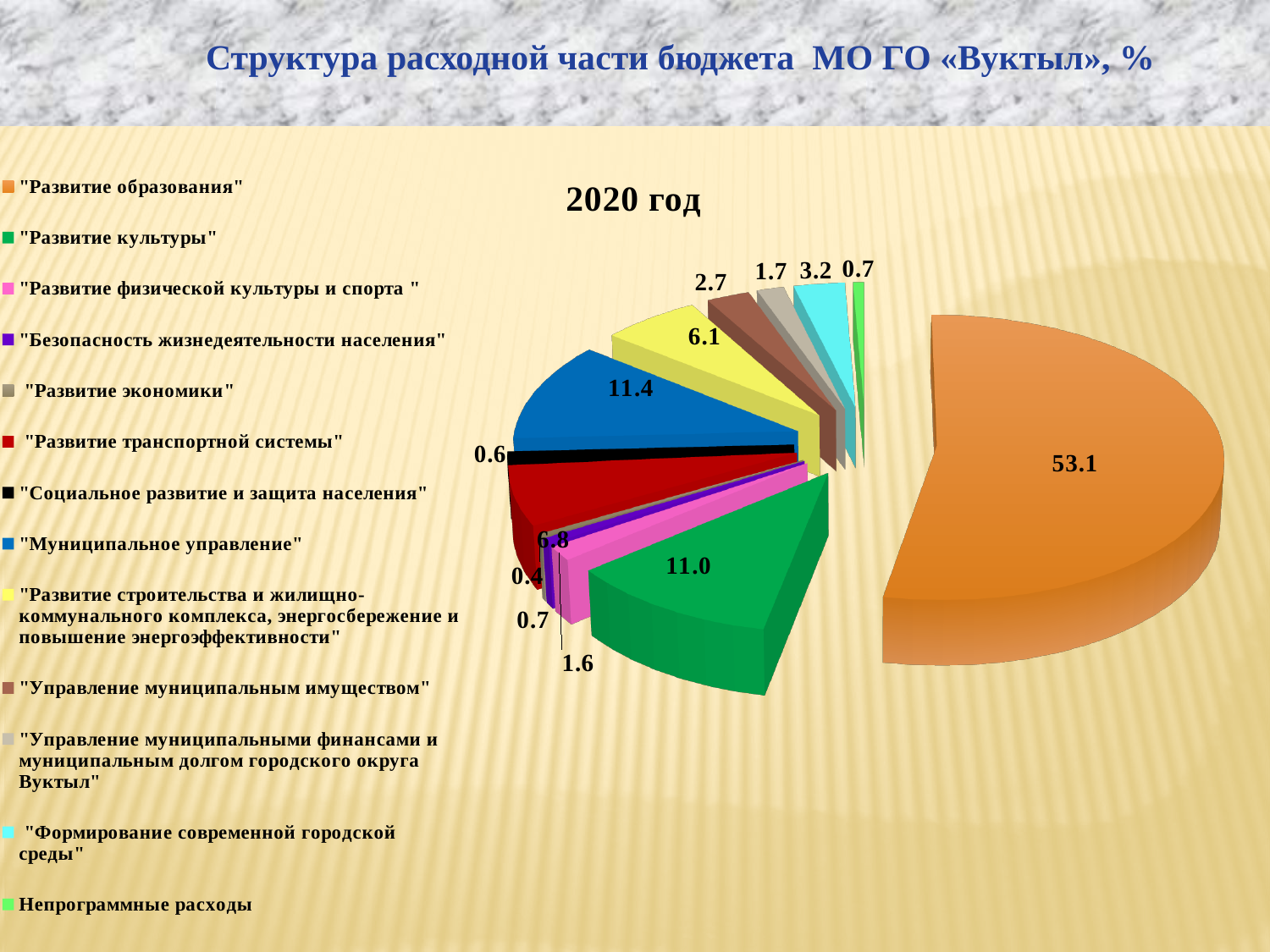
What is the value for "Муниципальное управление"? 11.4 How many categories does the legend list? 13 Which category has the largest share of the pie? "Развитие образования" What is the title shown above the chart? 2020 год What is the value for "Развитие транспортной системы"? 6.8 What is the value for "Развитие культуры"? 11.0 What colour is the slice for "Развитие образования"? orange What is the difference between the values for "Развитие образования" and "Муниципальное управление"? 41.7 What is the value for "Формирование современной городской среды"? 3.2 Which is larger: "Муниципальное управление" or "Развитие культуры"? "Муниципальное управление" What kind of chart is shown on the slide? pie chart What is the value for "Развитие образования"? 53.1